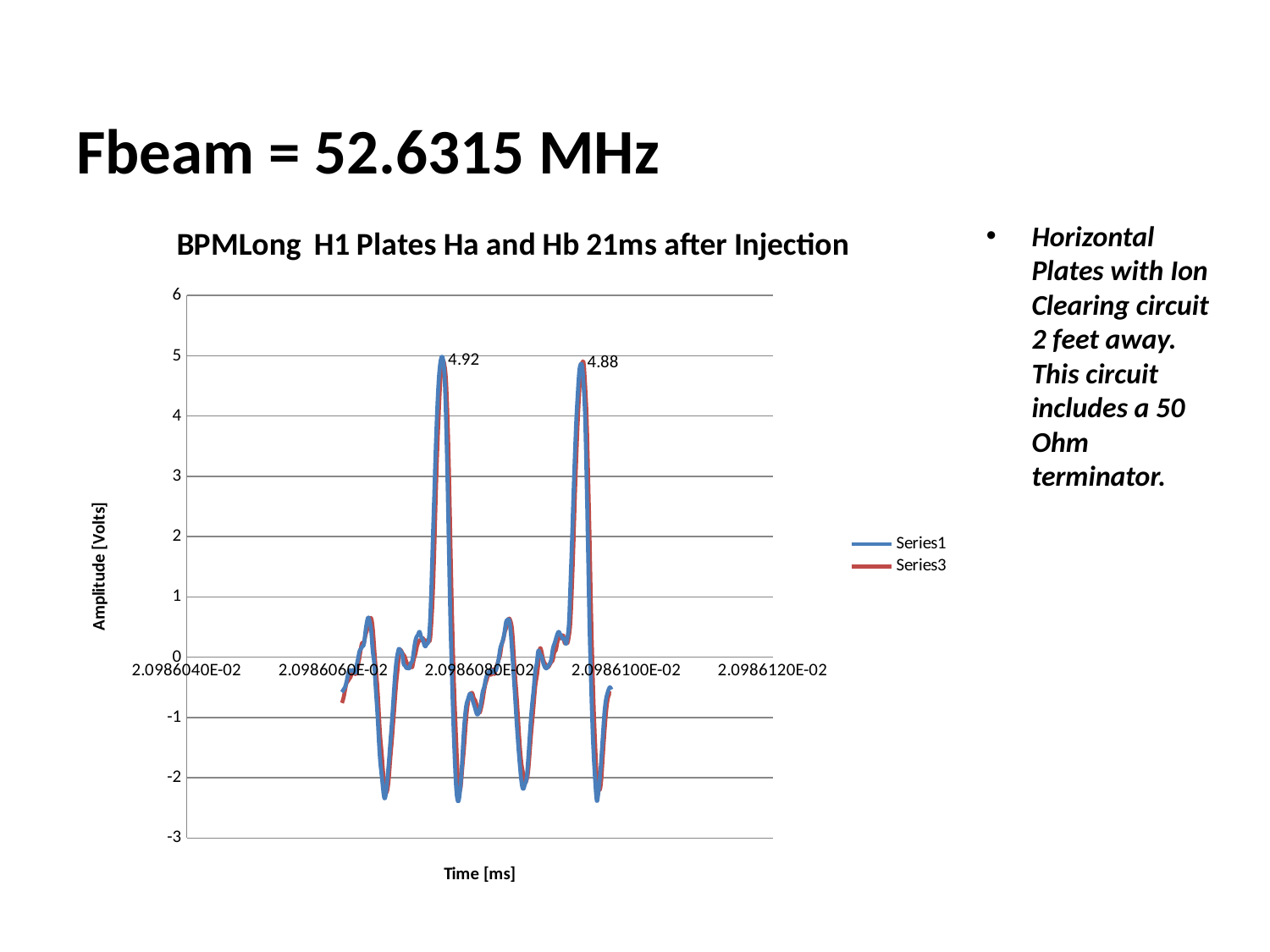
What is the difference between the two labelled peak values, 4.92 and 4.88? 0.04 What is the label of the vertical axis? Amplitude [Volts] What is the value printed on the first labelled peak of the chart? 4.92 What is the highest value shown on the vertical axis? 6 Is the lowest trough of the signal greater or less than -2? less Is the highest peak of the signal greater or less than 4? greater What is the title of the chart? BPMLong H1 Plates Ha and Hb 21ms after Injection How many series does the legend list? 2 Which of the two labelled peaks is higher, the first (4.92) or the second (4.88)? the first (4.92) What is the value printed on the second labelled peak of the chart? 4.88 How many data labels are printed on the chart? 2 What kind of chart is shown on the slide? line chart